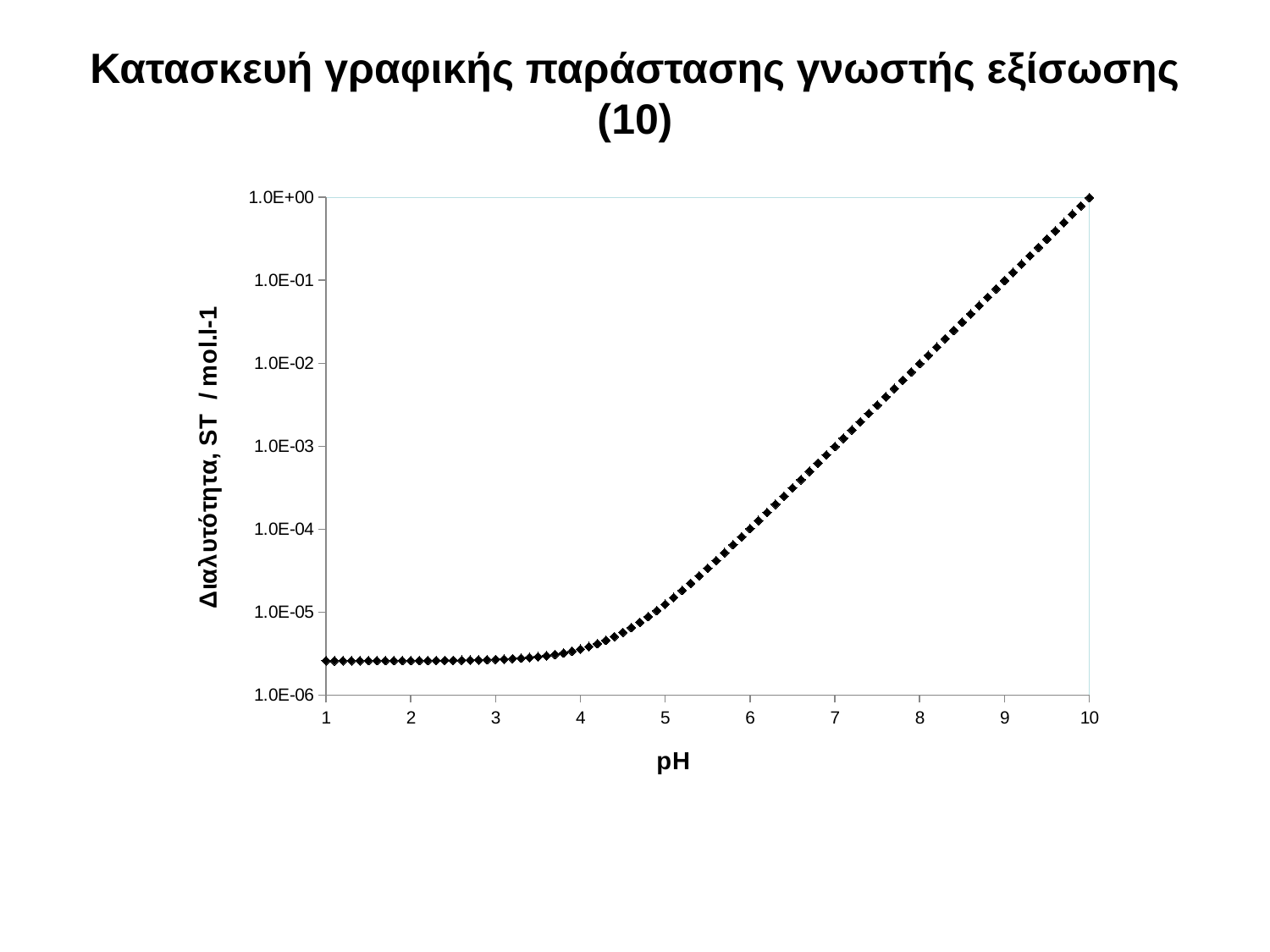
What is the label of the y axis? Διαλυτότητα, ST / mol.l-1 Is the value at pH 1 greater or less than 1.0E-05? less What is the lowest value shown on the y axis? 1.0E-06 Which has the larger solubility value, pH 3 or pH 8? pH 8 Is the value at pH 7 greater or less than 1.0E-02? less What kind of chart is shown on the slide? scatter chart Which has the larger solubility value, pH 6 or pH 9? pH 9 Is the value at pH 2 greater or less than 1.0E-04? less Do the plotted values rise or fall as pH increases from 5 to 10? rise At which pH value is the plotted solubility highest? 10 What is the label of the x axis? pH